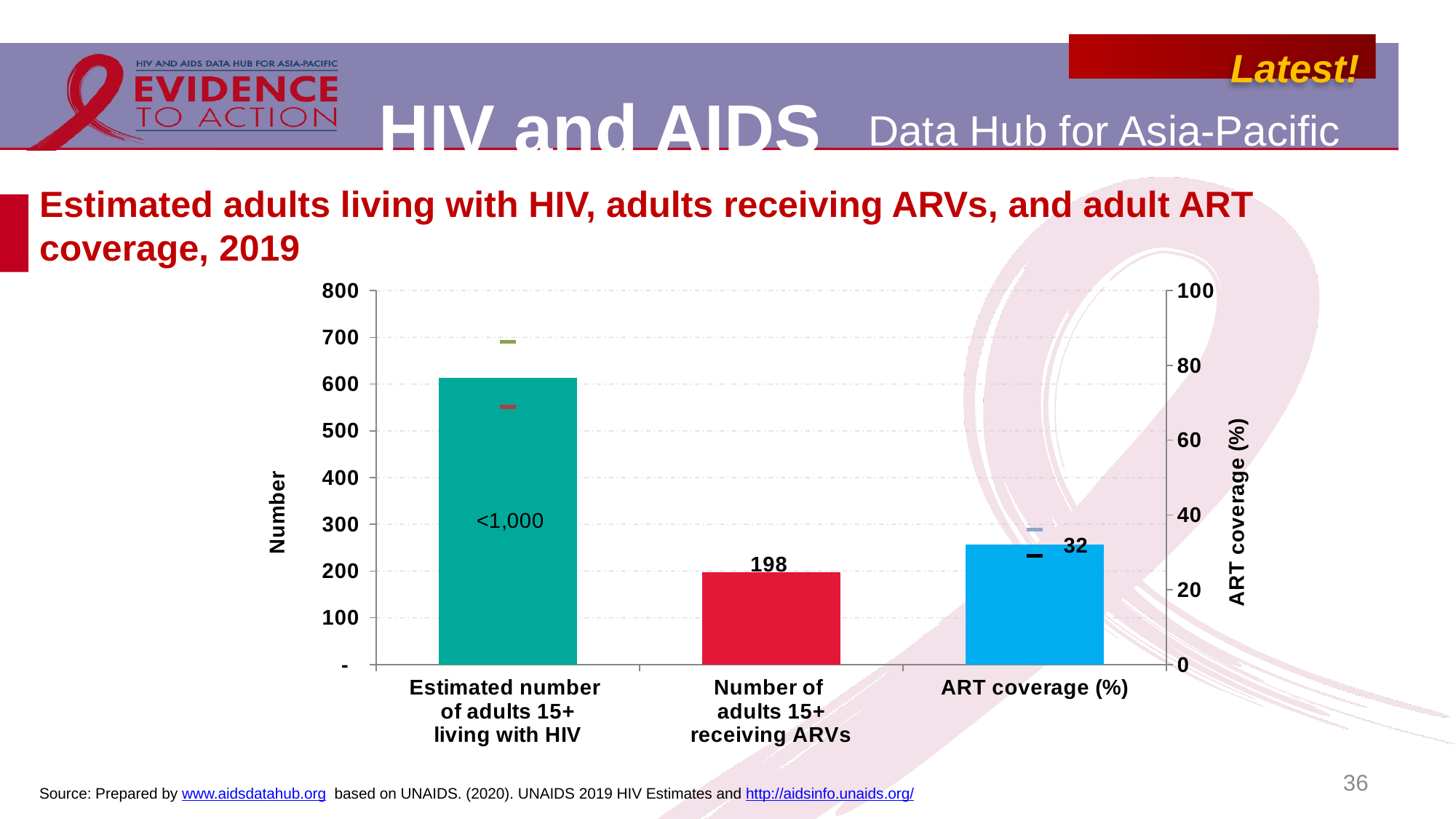
What is the value shown for the number of adults 15+ receiving ARVs? 198 Which is larger: the estimated number of adults 15+ living with HIV or the number of adults 15+ receiving ARVs? Estimated number of adults 15+ living with HIV What is the ART coverage (%) value shown on the chart? 32 Is the bar for the estimated number of adults 15+ living with HIV greater or less than 500 on the left axis? greater Is the bar for the estimated number of adults 15+ living with HIV greater or less than 700 on the left axis? less What data label is printed on the bar for the estimated number of adults 15+ living with HIV? <1,000 Which category has the tallest bar on the chart? Estimated number of adults 15+ living with HIV How many categories are shown on the x axis of the chart? 3 What is the title of the right vertical axis? ART coverage (%) What kind of chart is shown on the slide? Bar chart What is the title of the left vertical axis? Number